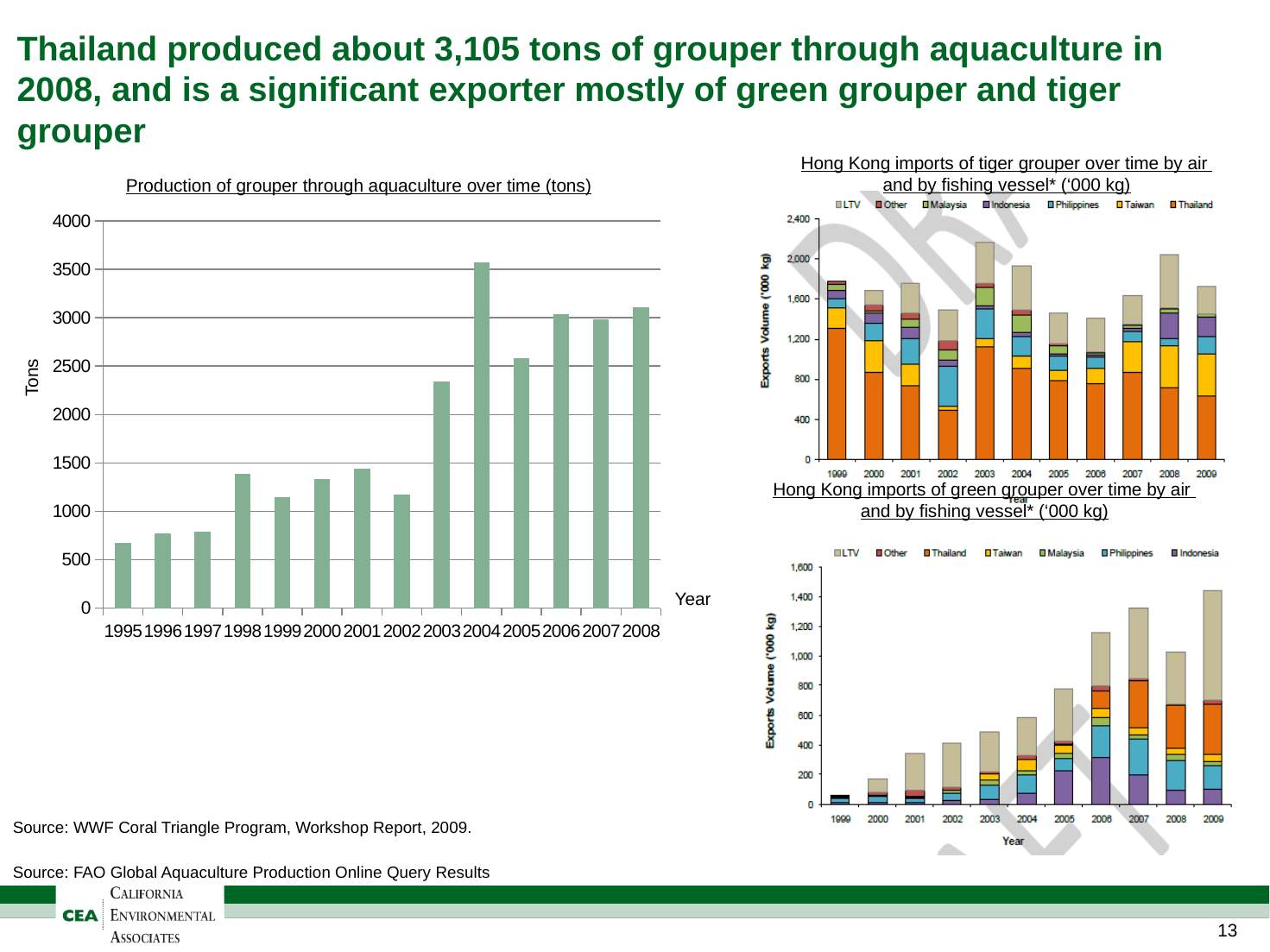
In the 'Production of grouper through aquaculture over time (tons)' chart, which year has the larger value, 2004 or 2005? 2004 In the 'Production of grouper through aquaculture over time (tons)' chart, which year has the lowest production? 1995 In the 'Production of grouper through aquaculture over time (tons)' chart, is the value for 2004 greater or less than 3500? greater In the 'Production of grouper through aquaculture over time (tons)' chart, which year has the highest production? 2004 In the 'Production of grouper through aquaculture over time (tons)' chart, which year has the larger value, 1998 or 1999? 1998 In the 'Production of grouper through aquaculture over time (tons)' chart, is the value for 2003 greater or less than 2000? greater In the 'Hong Kong imports of tiger grouper over time by air and by fishing vessel' chart, how many series does the legend list? 7 What kind of chart is 'Production of grouper through aquaculture over time (tons)'? bar chart In the 'Production of grouper through aquaculture over time (tons)' chart, how many years are plotted? 14 In the 'Production of grouper through aquaculture over time (tons)' chart, is the value for 1995 greater or less than 1000? less In the 'Hong Kong imports of green grouper over time by air and by fishing vessel' chart, how many years are plotted on the x axis? 11 In the 'Production of grouper through aquaculture over time (tons)' chart, do values generally rise or fall from 1995 to 2008? rise